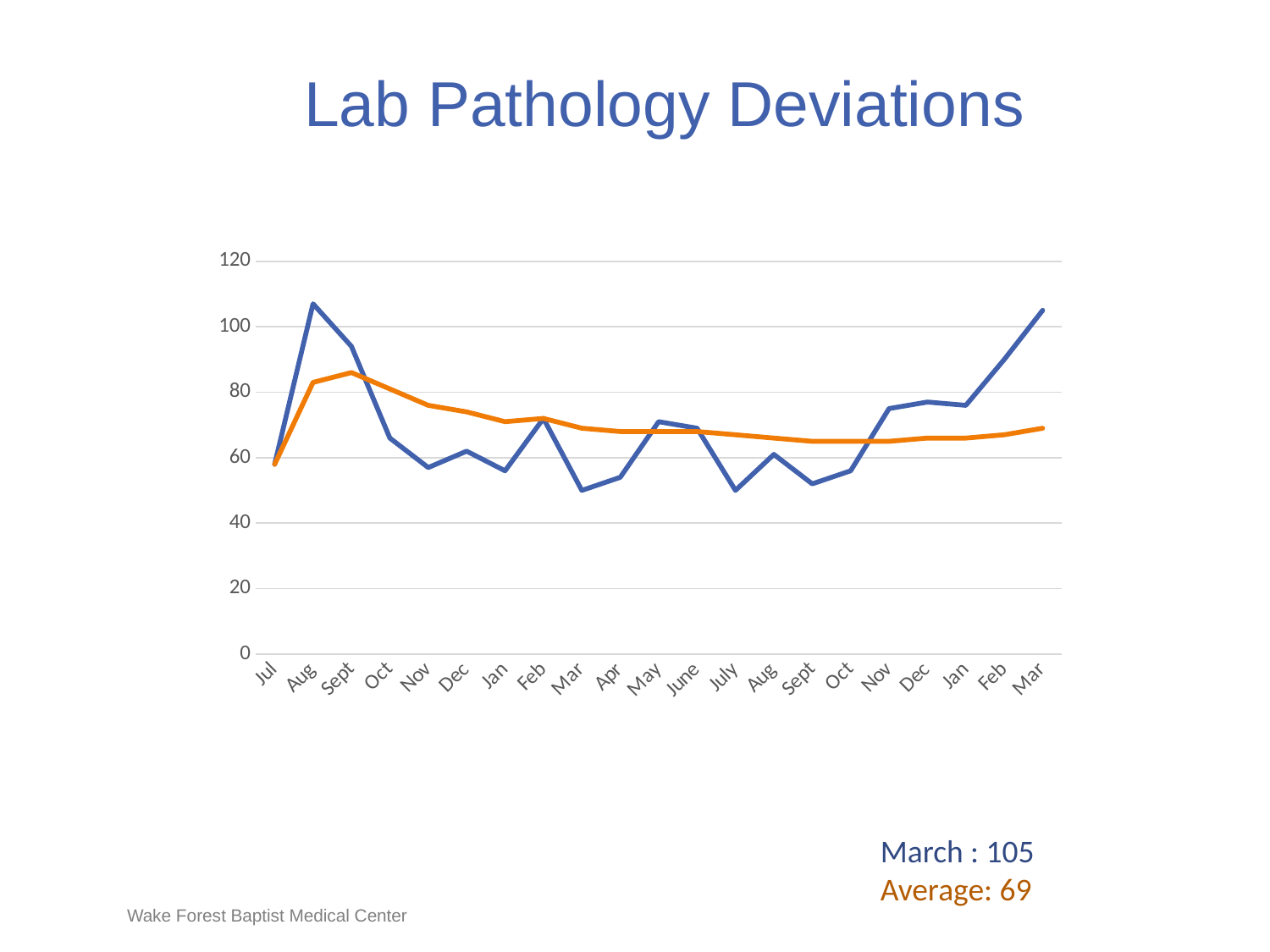
What kind of chart is shown on the slide? line chart At the first Mar point, which line has the higher value, the blue line or the orange line? orange line What is the title of the chart? Lab Pathology Deviations How many lines are plotted on the chart? 2 How many points are plotted along the x axis of the chart? 21 Is the value of the blue line at the first Mar point greater or less than 60? less Does the blue line rise or fall from the second Oct point to the final Mar point? rise What is the Average value printed on the slide? 69 What is the value of the blue line at the final Mar point, as printed on the slide? 105 Is the value of the blue line at the first Aug point greater or less than 100? greater At the first Aug point, which line has the higher value, the blue line or the orange line? blue line Is the value of the orange line at the first Sept point greater or less than 80? greater